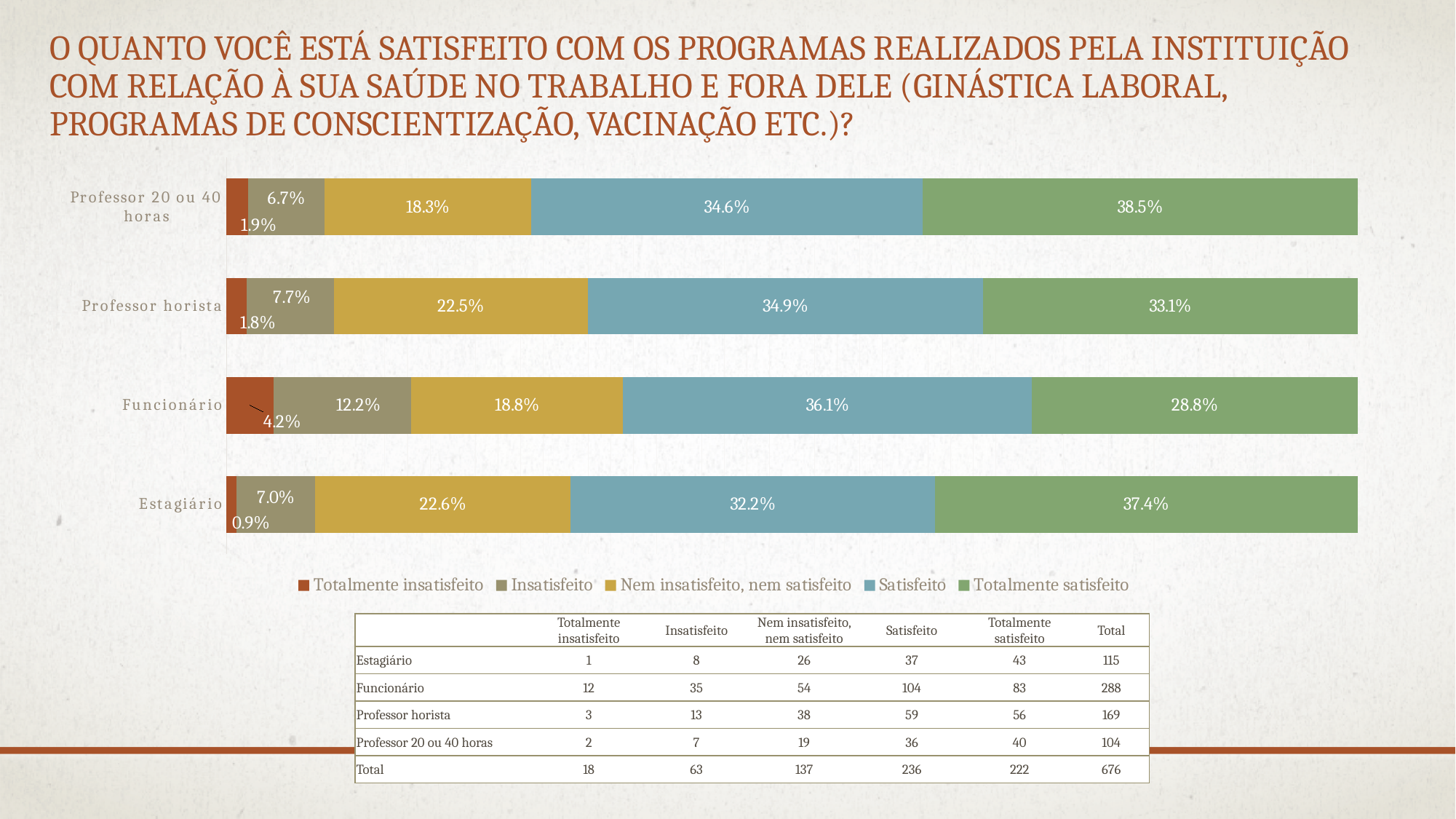
What is the Satisfeito value for Funcionário? 36.1% What percentage of Professor 20 ou 40 horas respondents answered Totalmente satisfeito? 38.5% Which has a larger Nem insatisfeito, nem satisfeito share, Funcionário or Estagiário? Estagiário What is the difference in Totalmente satisfeito percentage between Professor 20 ou 40 horas and Funcionário? 9.7 percentage points Which category has the highest Insatisfeito percentage? Funcionário Which category has the highest Totalmente satisfeito percentage? Professor 20 ou 40 horas What kind of chart is shown on the slide? Stacked bar chart How many categories (respondent groups) are shown in the chart? 4 What is the Totalmente insatisfeito value for Estagiário? 0.9% What is the Nem insatisfeito, nem satisfeito value for Professor horista? 22.5% How many series does the legend list? 5 Which category has the lowest Totalmente insatisfeito percentage? Estagiário